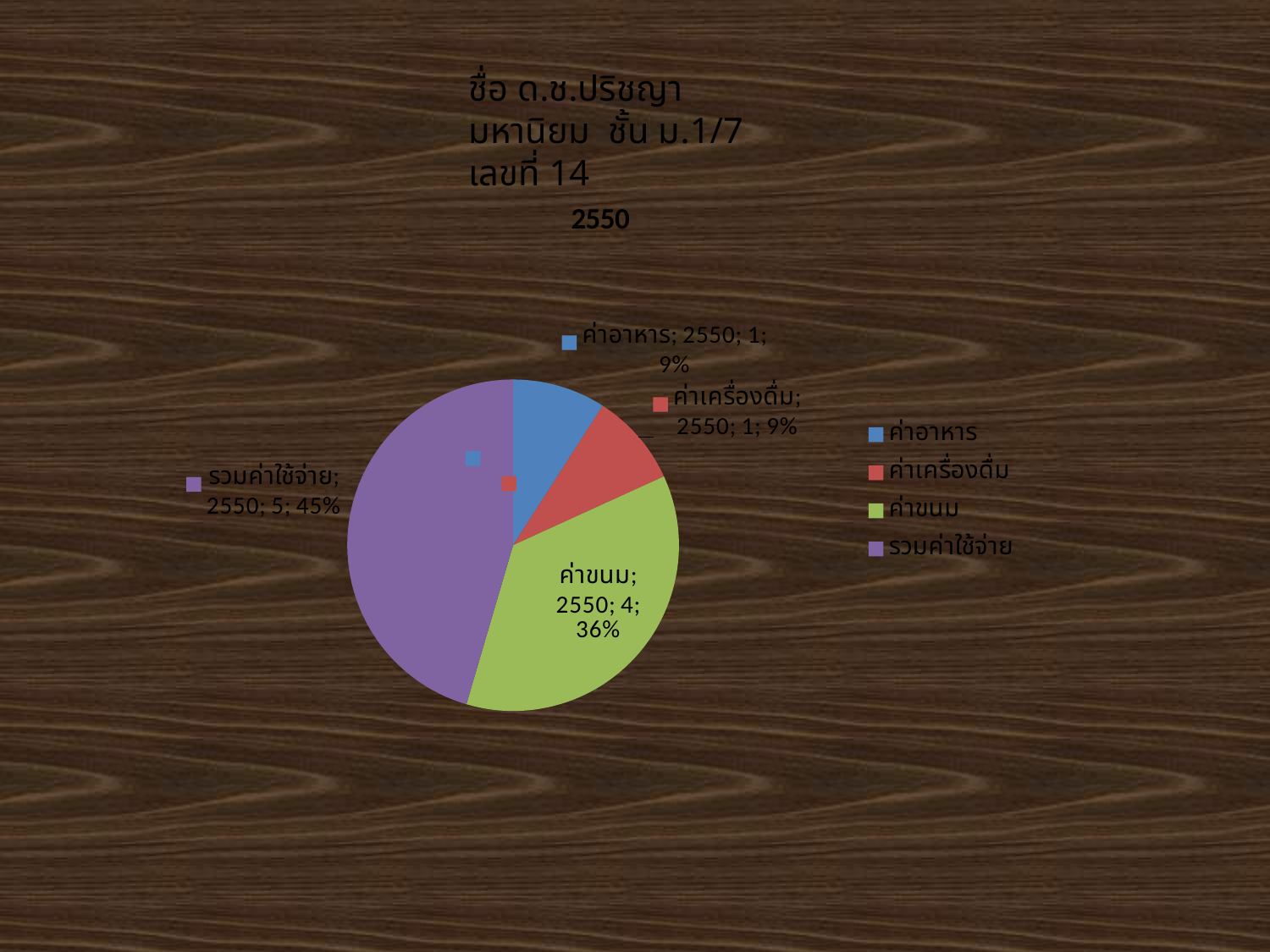
How many slices does the pie chart have? 4 What is the difference between the values for รวมค่าใช้จ่าย and ค่าขนม? 1 What is the title of the chart? 2550 What is the value for ค่าขนม? 4 Which category has the largest slice? รวมค่าใช้จ่าย What share of the pie does รวมค่าใช้จ่าย take? 45% Which is larger, the value for ค่าขนม or the value for ค่าเครื่องดื่ม? ค่าขนม How many entries does the legend list? 4 What share of the pie does ค่าขนม take? 36% What kind of chart is shown on the slide? pie chart What is the value for ค่าอาหาร? 1 What is the value for รวมค่าใช้จ่าย? 5